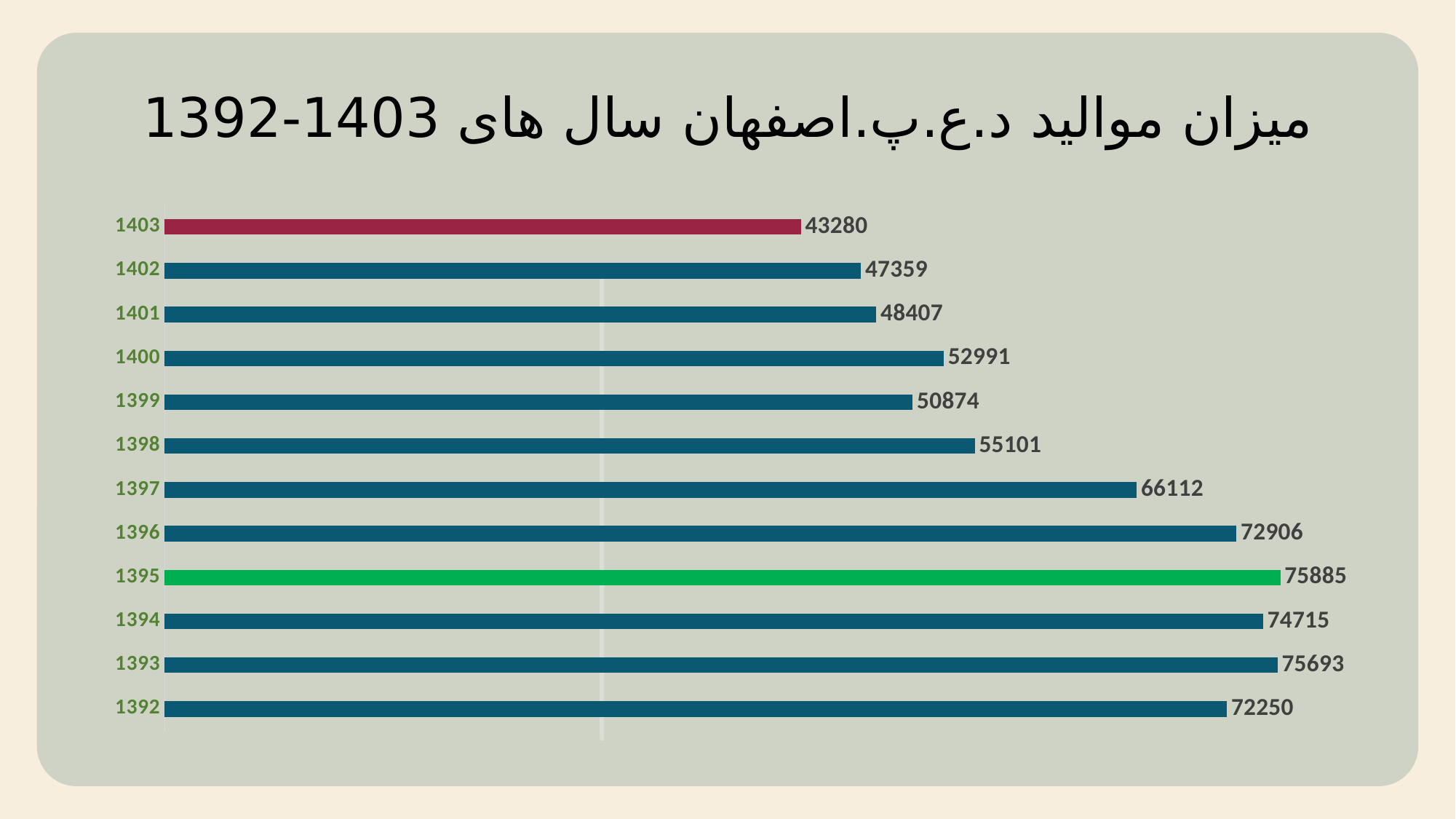
How many years are shown in the chart? 12 Which is larger, the value for 1399 or the value for 1400? 1400 What is the value for 1395? 75885 What kind of chart is shown on the slide? bar chart Do the values generally rise or fall from 1392 to 1403? fall What is the value for 1403? 43280 What is the value for 1392? 72250 What is the difference between the values for 1402 and 1403? 4079 Which year has the lowest value? 1403 What is the difference between the values for 1396 and 1397? 6794 Which year has the highest value? 1395 What is the value for 1398? 55101